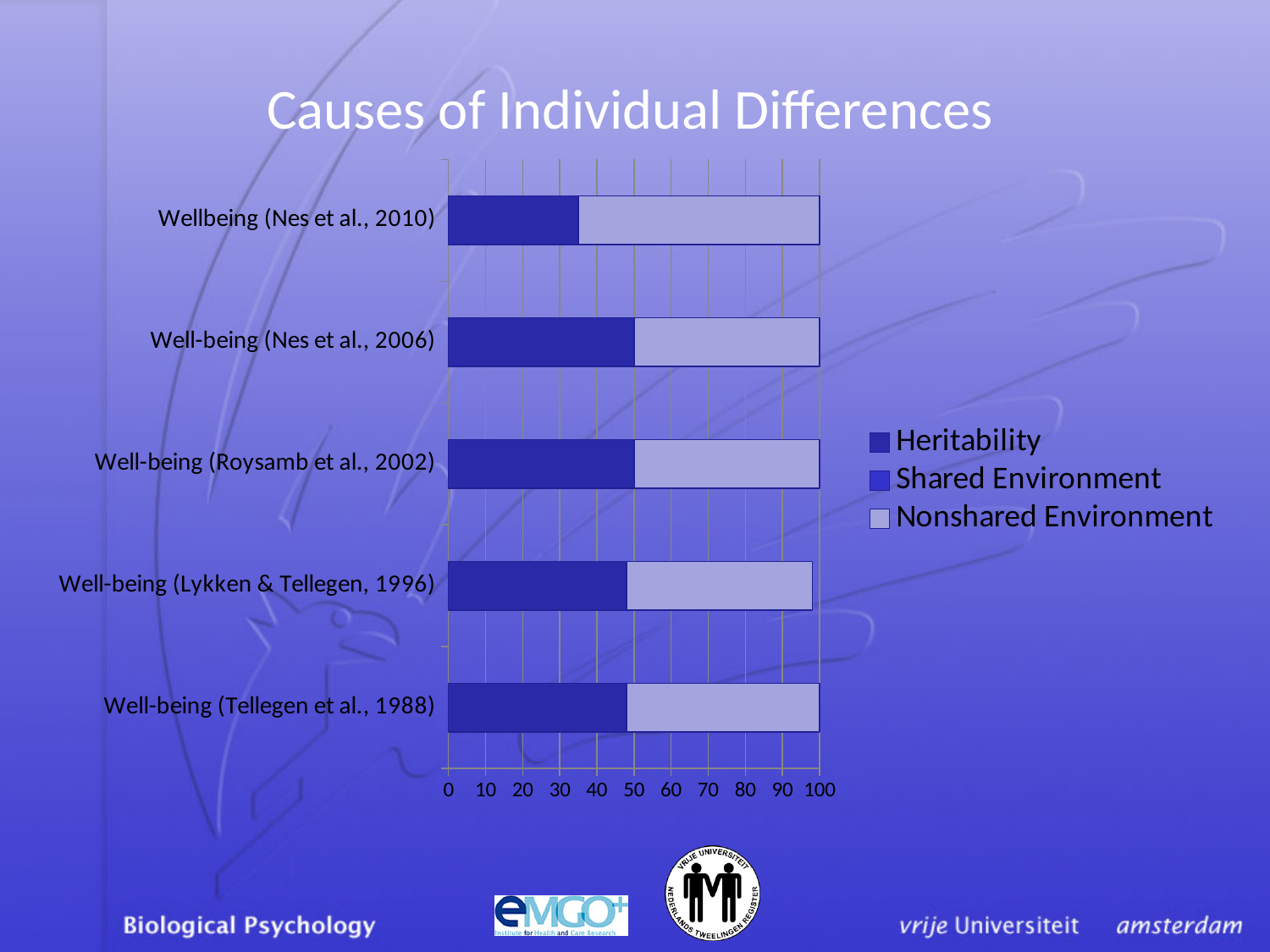
Is the Heritability value for Wellbeing (Nes et al., 2010) greater or less than 40? less Is the Heritability value for Well-being (Nes et al., 2006) greater or less than 40? greater How many categories (studies) are plotted on the chart? 5 Which study has the lowest Heritability value? Wellbeing (Nes et al., 2010) Which series is listed last in the legend? Nonshared Environment Is the Heritability value for Well-being (Tellegen et al., 1988) greater or less than 40? greater Which has the larger Heritability value: Wellbeing (Nes et al., 2010) or Well-being (Nes et al., 2006)? Well-being (Nes et al., 2006) What kind of chart is shown on the slide? Stacked bar chart How many series does the legend list? 3 What is the title of the chart on the slide? Causes of Individual Differences